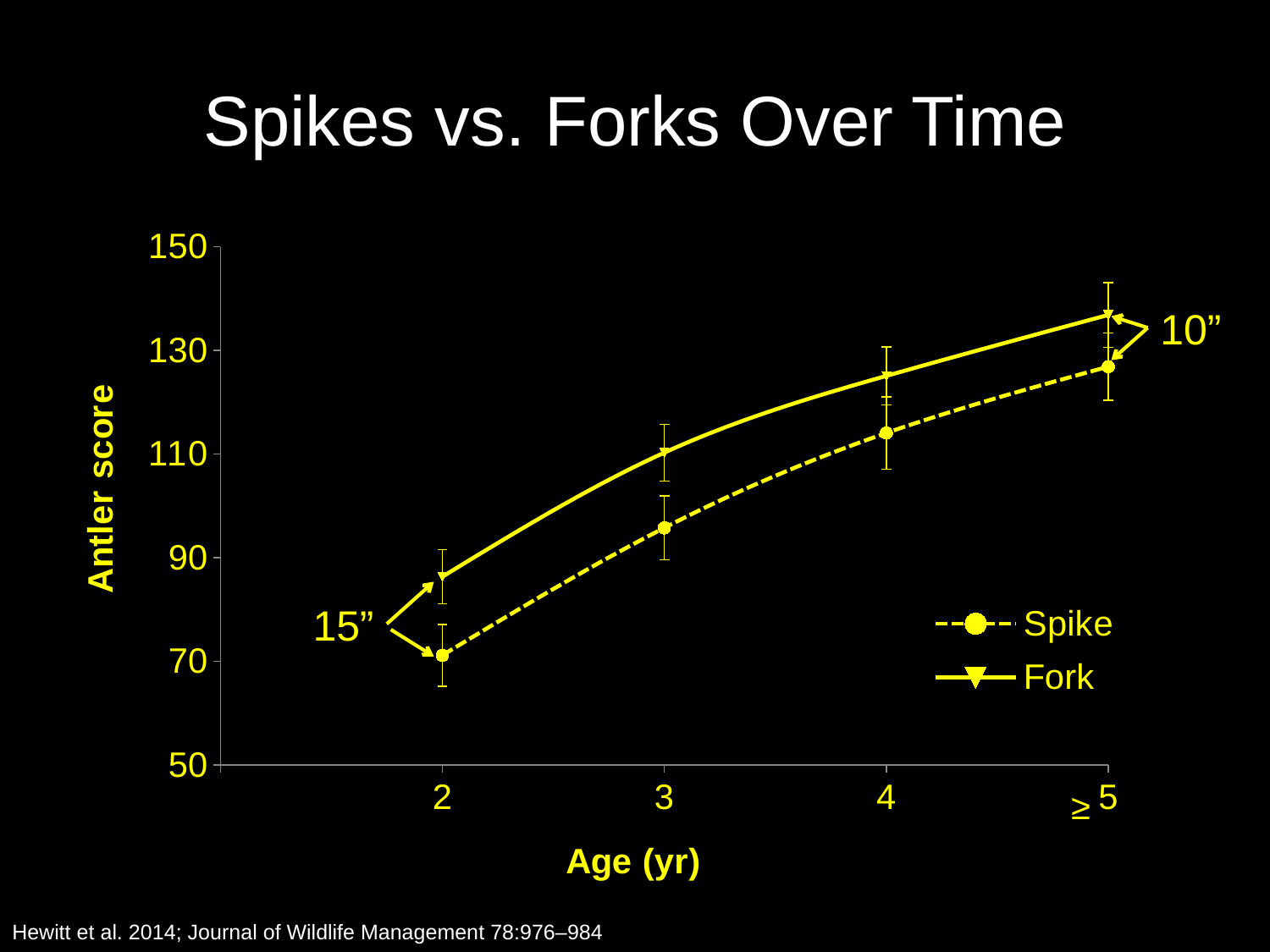
Is the Fork antler score at age 4 greater or less than 110? greater What kind of chart is shown on the slide? line chart Is the Spike antler score at age 2 greater or less than 90? less How many series does the legend list? 2 At which age is the Spike antler score lowest? 2 What difference is annotated between the Spike and Fork lines at age 2? 15" At which age is the Fork antler score highest? ≥ 5 Do the antler scores for the Fork series rise or fall as age increases? rise What is the title of the chart? Spikes vs. Forks Over Time At age 3, which series has the higher antler score, Spike or Fork? Fork Is the Fork antler score at age ≥ 5 greater or less than 130? greater How many age categories are shown on the x axis? 4